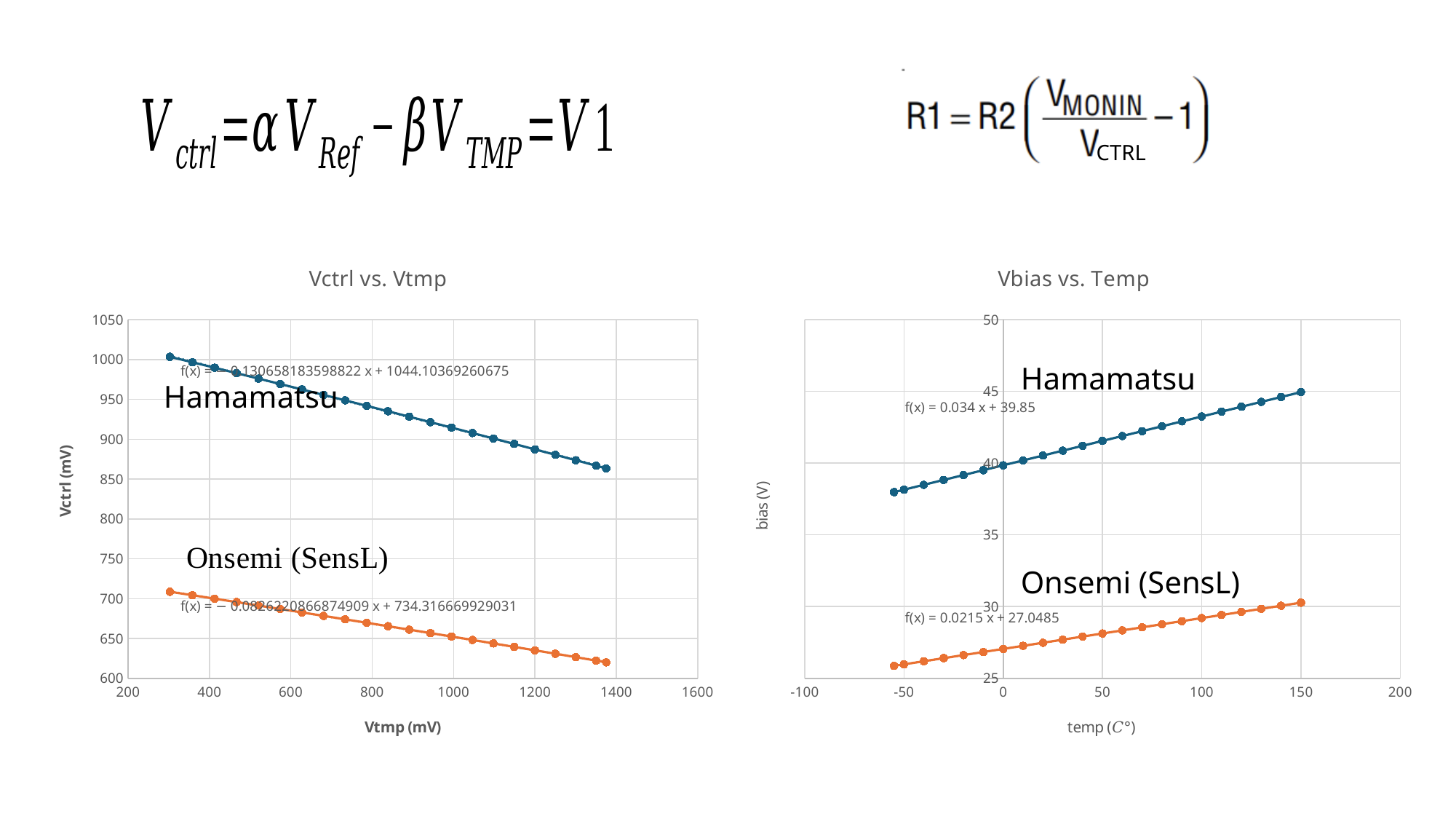
In the "Vbias vs. Temp" chart, is the Hamamatsu value at -50 °C greater or less than 40? less In the "Vbias vs. Temp" chart, which series has the lower bias values, Hamamatsu or Onsemi (SensL)? Onsemi (SensL) What is the fitted trendline equation shown for Hamamatsu in the "Vbias vs. Temp" chart? f(x) = 0.034 x + 39.85 In the "Vbias vs. Temp" chart, is the Onsemi (SensL) value at -50 °C greater or less than 25? greater What kind of chart is the "Vctrl vs. Vtmp" chart? line chart In the "Vctrl vs. Vtmp" chart, do the Hamamatsu values rise or fall as Vtmp increases? fall In the "Vctrl vs. Vtmp" chart, is the Onsemi (SensL) value at Vtmp 300 mV greater or less than 700? greater What is the x-axis label of the "Vctrl vs. Vtmp" chart? Vtmp (mV) In the "Vctrl vs. Vtmp" chart, which series has the higher Vctrl values, Hamamatsu or Onsemi (SensL)? Hamamatsu In the "Vbias vs. Temp" chart, do the Onsemi (SensL) values rise or fall as temperature increases? rise How many data series are plotted in the "Vbias vs. Temp" chart? 2